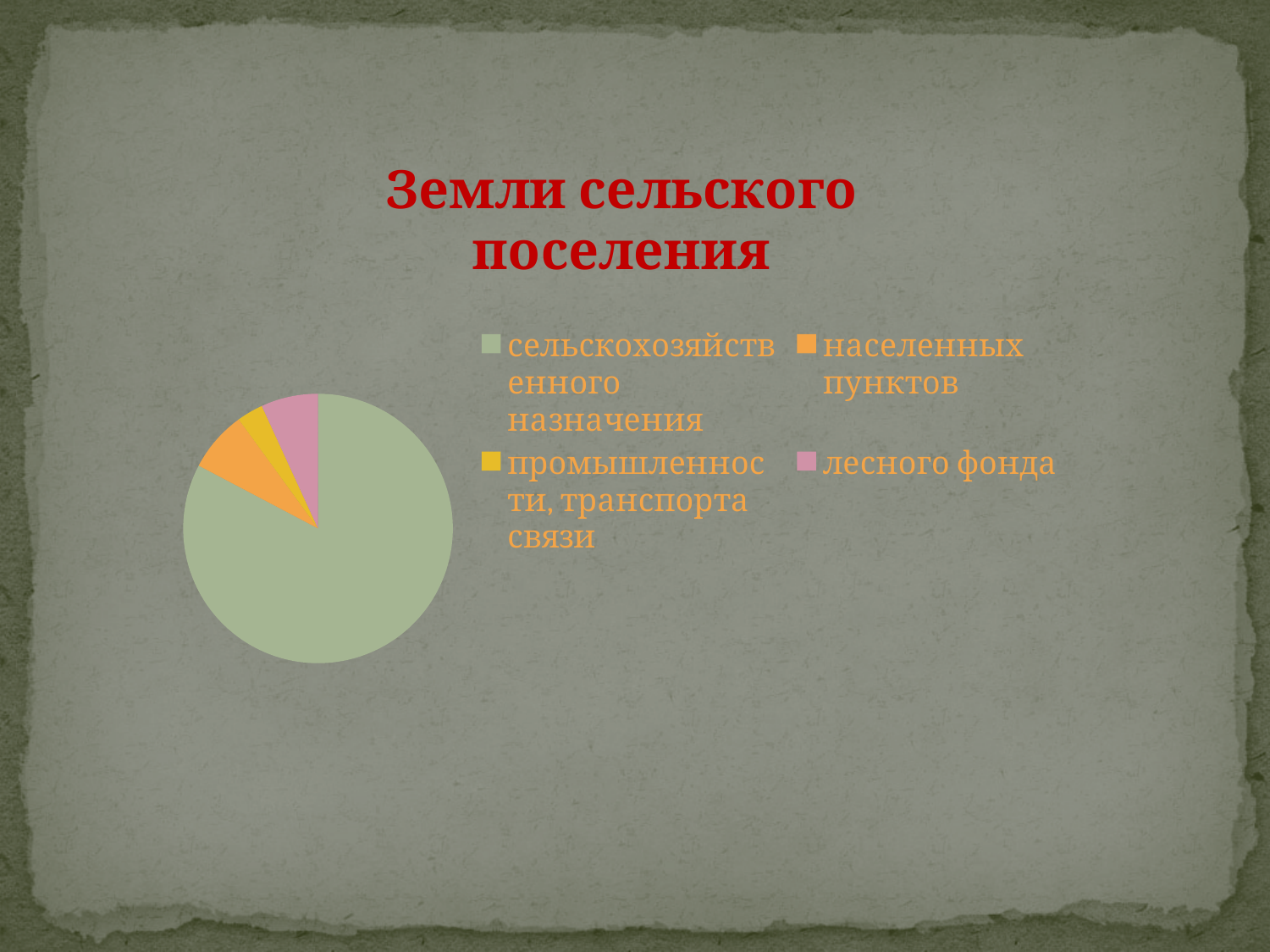
Which slice is larger: сельскохозяйственного назначения or лесного фонда? сельскохозяйственного назначения Does the slice for сельскохозяйственного назначения take up more or less than half of the pie? more Which category has the largest slice of the pie? сельскохозяйственного назначения What colour is the slice for сельскохозяйственного назначения? green What is the title of the chart on the slide? Земли сельского поселения Which slice is larger: лесного фонда or промышленности, транспорта связи? лесного фонда Which category has the smallest slice of the pie? промышленности, транспорта связи Which slice is larger: населенных пунктов or промышленности, транспорта связи? населенных пунктов How many categories (slices) does the pie chart have? 4 What kind of chart is shown on the slide? pie chart